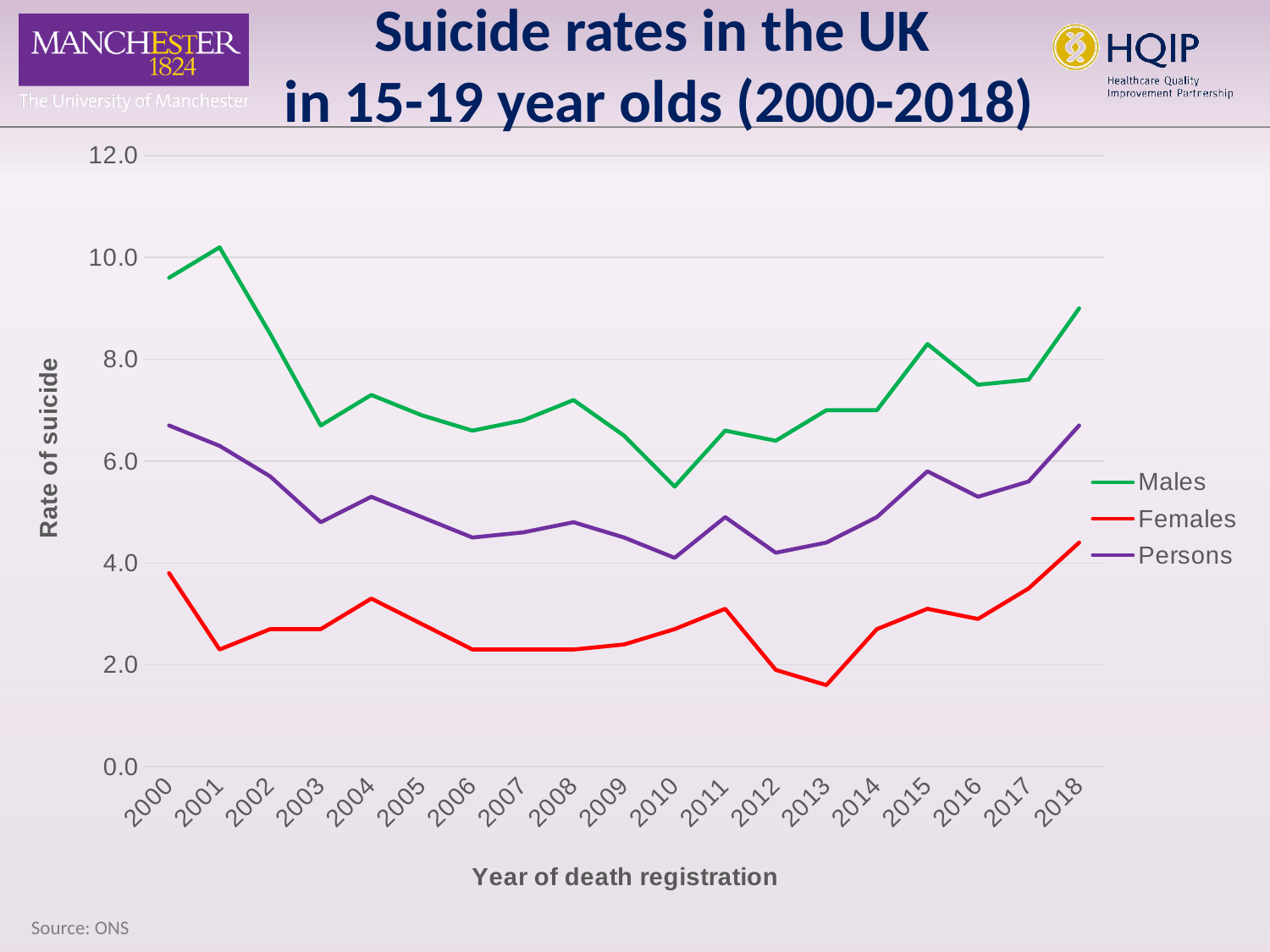
Does the Females line rise or fall from 2013 to 2018? rise Is the value for Males in 2000 greater or less than 8.0? greater In which year is the Males line at its highest? 2001 Is the value for Persons in 2010 greater or less than 6.0? less Is the value for Females in 2013 greater or less than 2.0? less How many series does the legend list? 3 What kind of chart is shown on the slide? line chart In which year is the Males line at its lowest? 2010 Which series has the higher value in 2010, Males or Females? Males How many years are plotted along the x axis? 19 In which year is the Females line at its highest? 2018 In which year is the Females line at its lowest? 2013